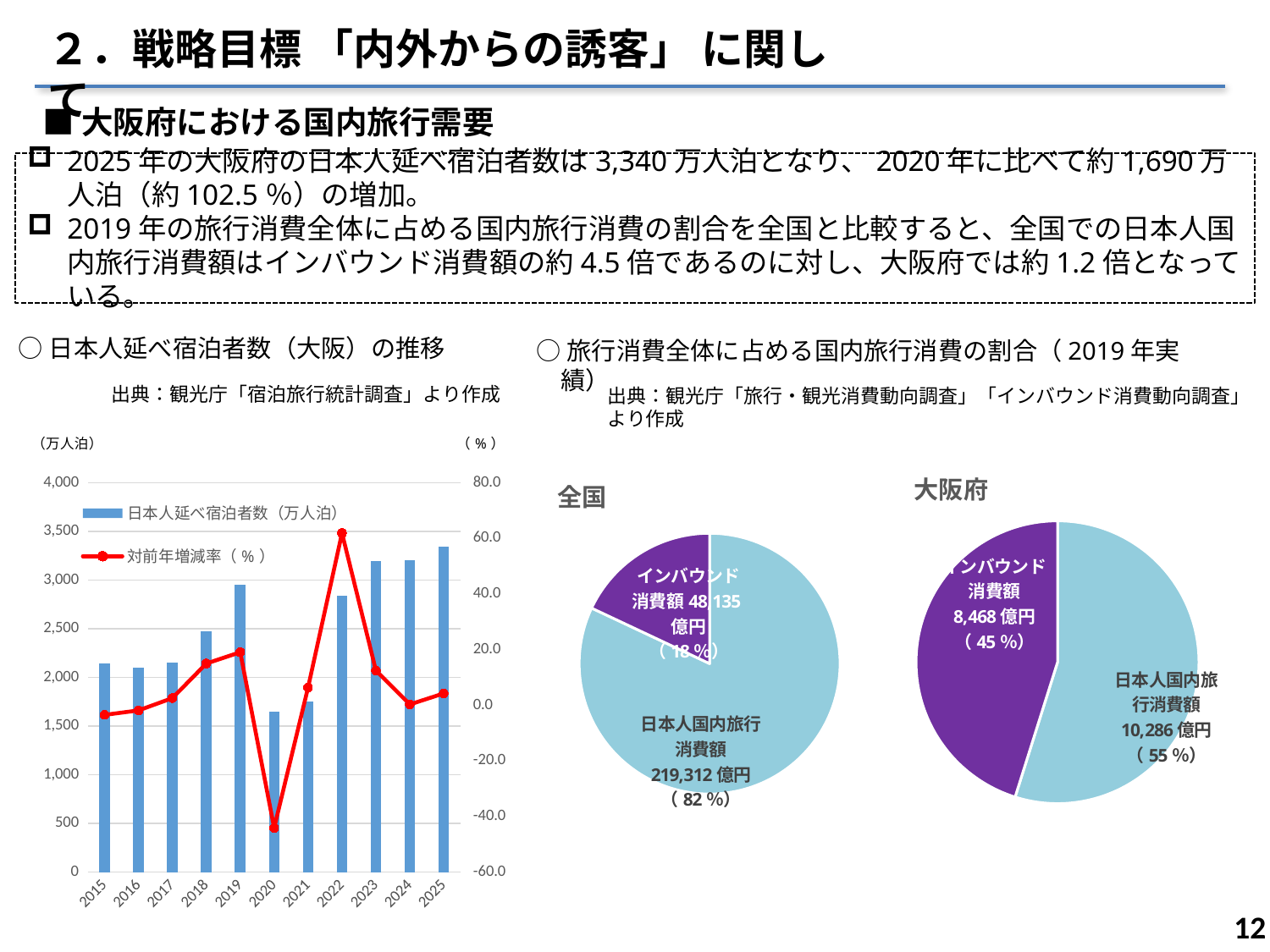
In the left chart (日本人延べ宿泊者数（大阪）の推移), in which year does the 対前年増減率 line reach its highest point? 2022 In the 大阪府 pie chart, what is the difference between 日本人国内旅行消費額 and インバウンド消費額? 1,818 億円 In the left chart (日本人延べ宿泊者数（大阪）の推移), do the bars rise or fall from 2020 to 2025? rise In the 全国 pie chart, what share of the pie is 日本人国内旅行消費額? 82% In the left chart (日本人延べ宿泊者数（大阪）の推移), what kind of chart is it? A bar chart combined with a line chart In the 全国 pie chart, what is the value of インバウンド消費額? 48,135 億円 In the left chart (日本人延べ宿泊者数（大阪）の推移), is the bar value for 2020 greater or less than 2,000? less In the left chart (日本人延べ宿泊者数（大阪）の推移), how many years are shown on the x axis? 11 In the left chart (日本人延べ宿泊者数（大阪）の推移), how many series does the legend list? 2 In the 大阪府 pie chart, which is larger, インバウンド消費額 or 日本人国内旅行消費額? 日本人国内旅行消費額 In the left chart (日本人延べ宿泊者数（大阪）の推移), which year has the lowest bar for 日本人延べ宿泊者数? 2020 In the left chart (日本人延べ宿泊者数（大阪）の推移), is the 対前年増減率 value for 2022 greater or less than 40.0? greater